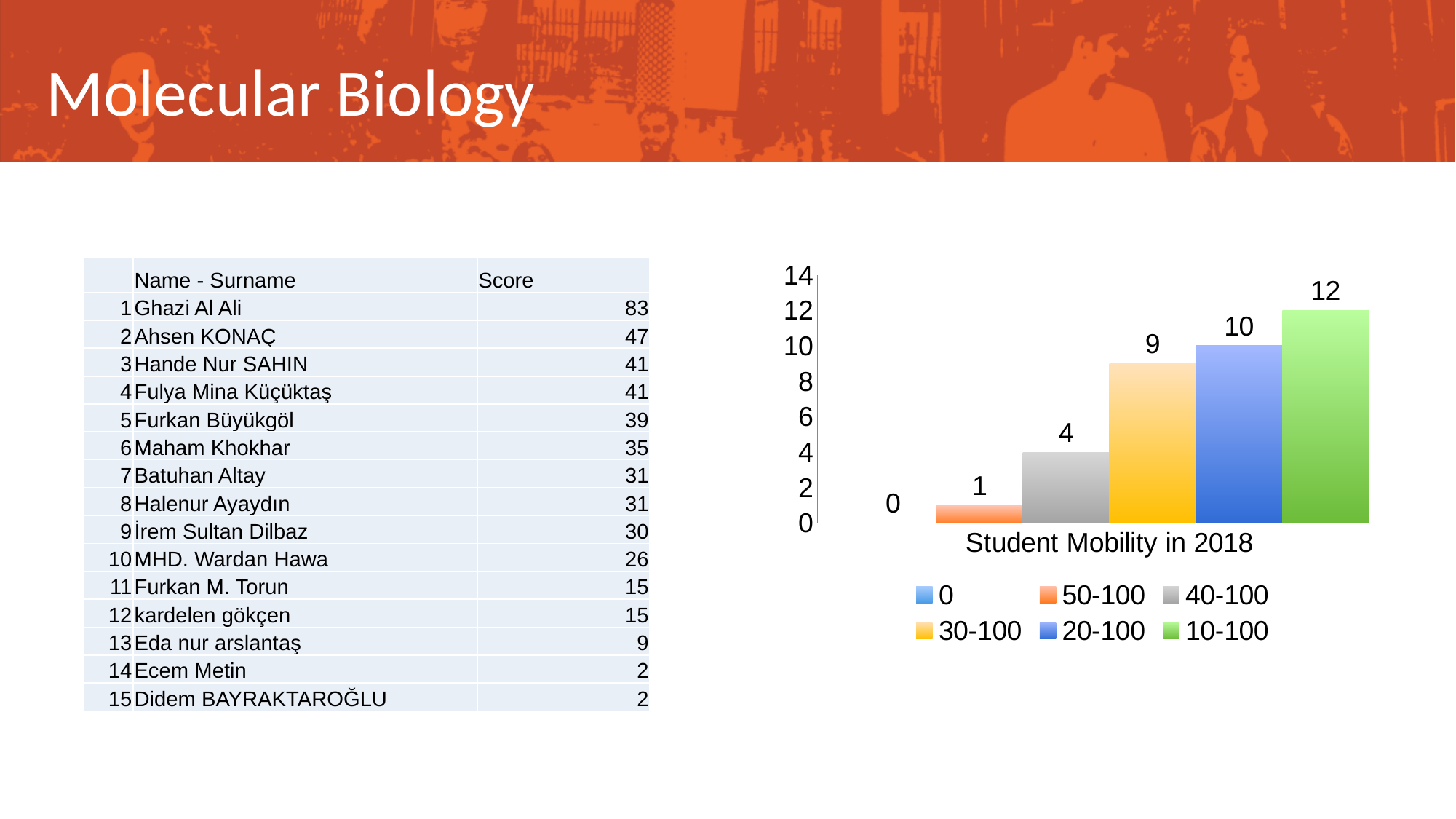
What type of chart is shown on the slide? bar chart What is the difference between the values for the 10-100 and 20-100 series? 2 Which series has the highest value in the chart? 10-100 How many series does the chart legend list? 6 What is the value for the 40-100 series in the chart? 4 What is the category label shown on the x axis of the chart? Student Mobility in 2018 Which is larger, the value for 30-100 or the value for 40-100? 30-100 What is the value for the 50-100 series in the chart? 1 Which series has the lowest value in the chart? 0 What colour is the bar for the 10-100 series? green What is the value for the 30-100 series in the chart? 9 What is the value for the 10-100 series in the chart? 12